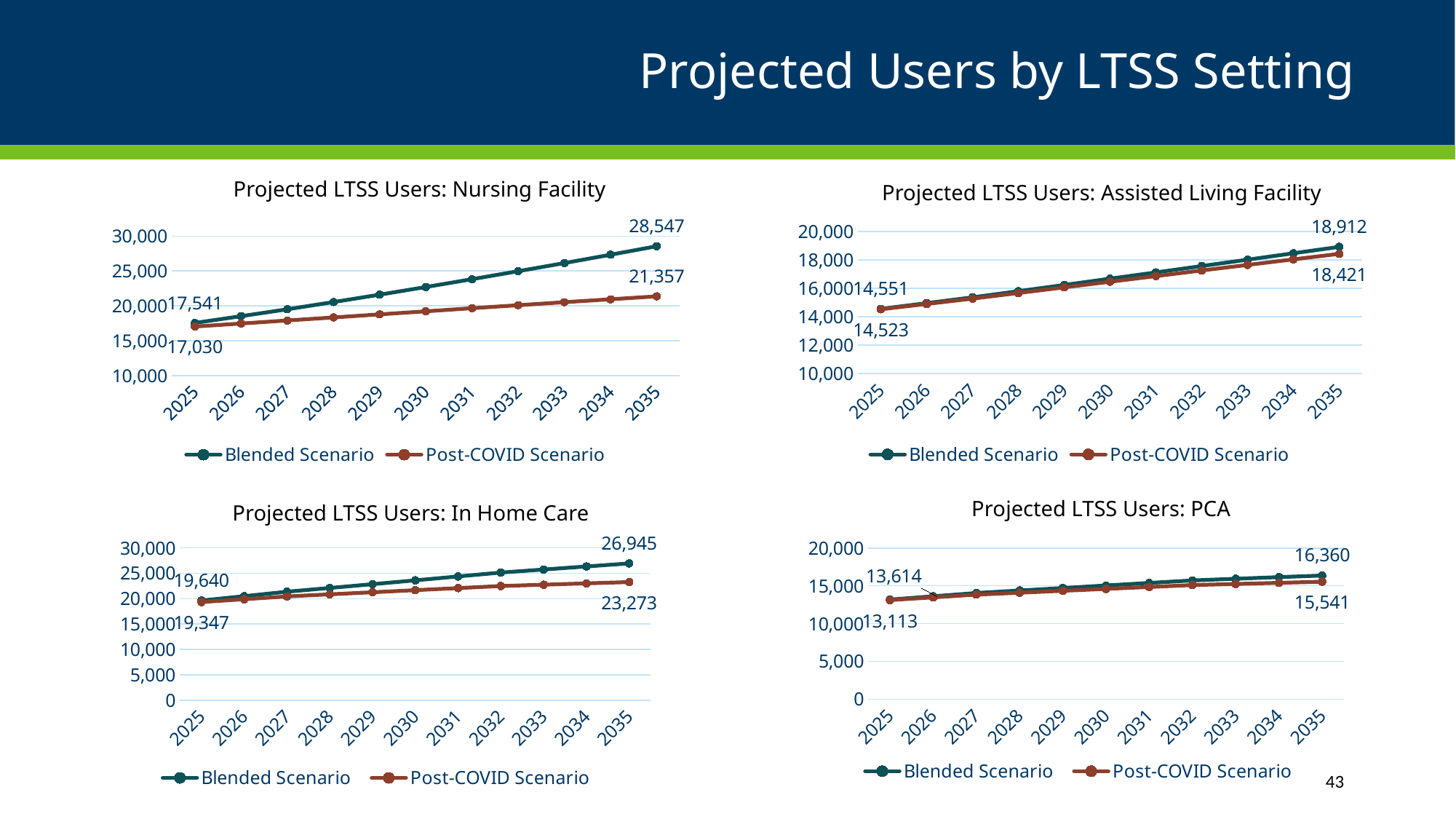
In the Projected LTSS Users: Nursing Facility chart, what is the difference between the Blended Scenario and Post-COVID Scenario values in 2035? 7,190 What kind of chart is the Projected LTSS Users: PCA chart? Line chart In the Projected LTSS Users: PCA chart, what is the Post-COVID Scenario value for 2025? 13,113 In the Projected LTSS Users: Nursing Facility chart, what is the Blended Scenario value for 2035? 28,547 In the Projected LTSS Users: In Home Care chart, what is the Blended Scenario value for 2035? 26,945 In the Projected LTSS Users: In Home Care chart, what is the difference between the Blended Scenario and Post-COVID Scenario values in 2035? 3,672 In the Projected LTSS Users: PCA chart, which scenario has the higher value in 2035? Blended Scenario How many years are plotted on the x axis of the Projected LTSS Users: In Home Care chart? 11 In the Projected LTSS Users: Nursing Facility chart, what is the Post-COVID Scenario value for 2025? 17,030 In the Projected LTSS Users: Assisted Living Facility chart, what is the Post-COVID Scenario value for 2035? 18,421 In the Projected LTSS Users: Nursing Facility chart, is the Blended Scenario value for 2030 greater or less than 20,000? greater In the Projected LTSS Users: Assisted Living Facility chart, what is the Blended Scenario value for 2025? 14,551